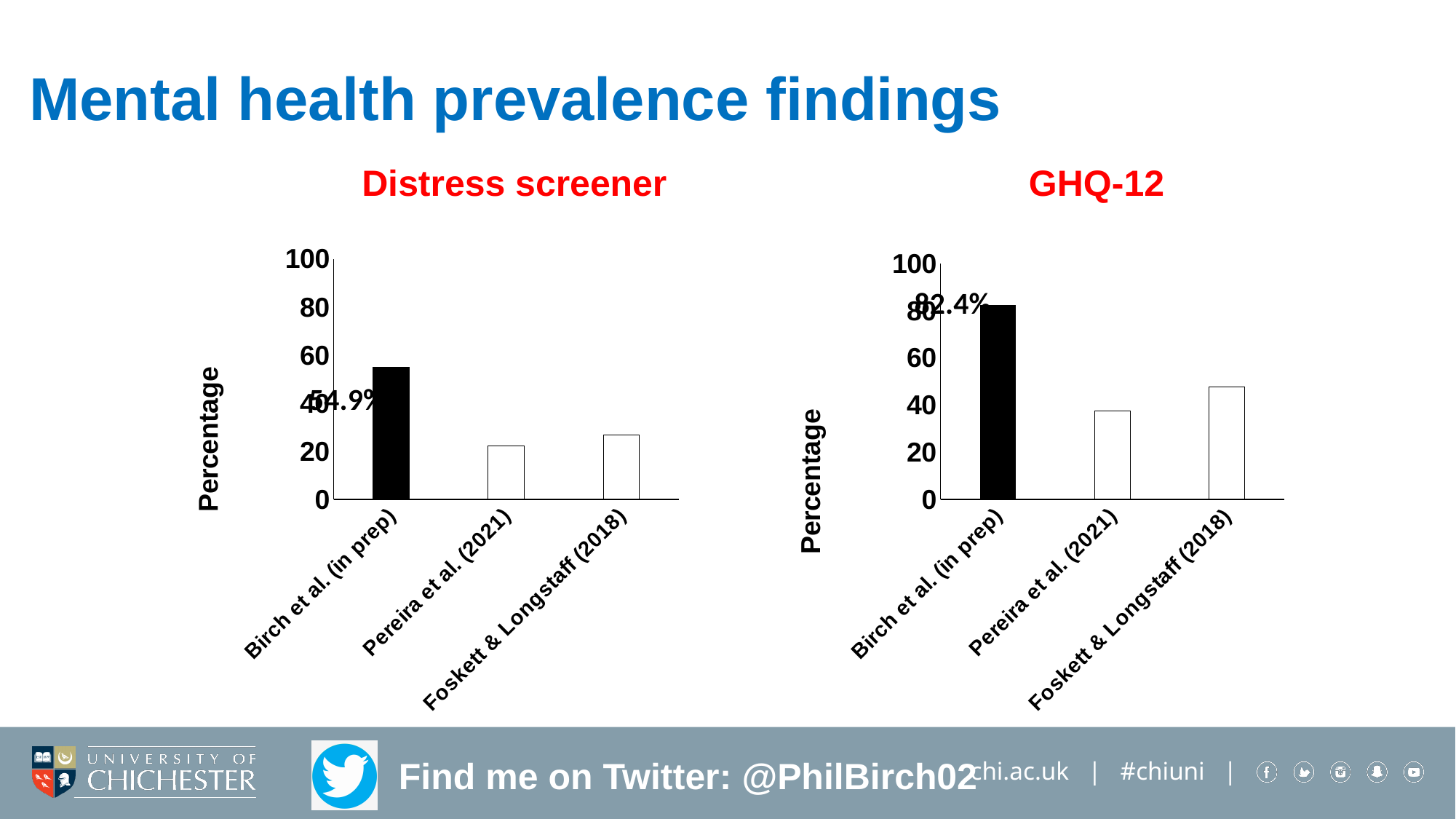
On the Distress screener chart, what percentage is labelled for Birch et al. (in prep)? 54.9% On the GHQ-12 chart, what percentage is labelled for Birch et al. (in prep)? 82.4% On the GHQ-12 chart, which study has the lowest percentage? Pereira et al. (2021) On the GHQ-12 chart, which study has the highest percentage? Birch et al. (in prep) How many studies are shown on the Distress screener chart? 3 What kind of chart is the Distress screener chart? bar chart On the GHQ-12 chart, which is larger: Foskett & Longstaff (2018) or Pereira et al. (2021)? Foskett & Longstaff (2018) What is the y-axis label on the GHQ-12 chart? Percentage On the Distress screener chart, which study has the highest percentage? Birch et al. (in prep) On the GHQ-12 chart, is the value for Foskett & Longstaff (2018) greater or less than 40? greater On the Distress screener chart, is the value for Pereira et al. (2021) greater or less than 40? less On the Distress screener chart, which study has the lowest percentage? Pereira et al. (2021)